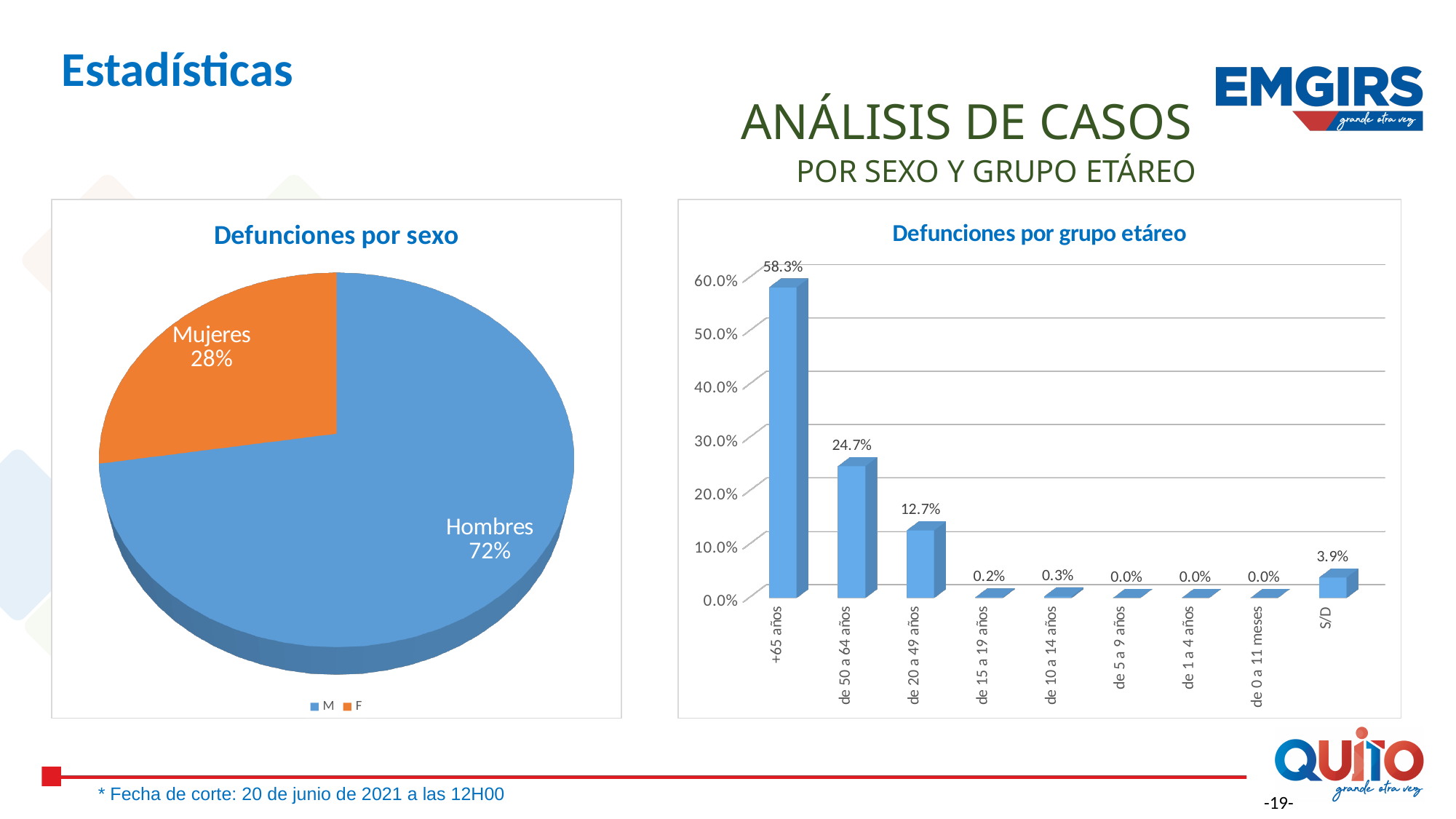
In the 'Defunciones por grupo etáreo' chart, what is the value for S/D? 3.9% In the 'Defunciones por grupo etáreo' chart, is the value for de 50 a 64 años greater or less than 20.0%? greater What kind of chart is 'Defunciones por sexo'? Pie chart What kind of chart is 'Defunciones por grupo etáreo'? Bar chart In the 'Defunciones por sexo' chart, what is the value for Mujeres? 28% In the 'Defunciones por sexo' chart, what share of the pie is Hombres? 72% In the 'Defunciones por grupo etáreo' chart, which age group has the highest value? +65 años In the 'Defunciones por grupo etáreo' chart, what is the value for de 20 a 49 años? 12.7% In the 'Defunciones por grupo etáreo' chart, how many categories are shown on the x axis? 9 In the 'Defunciones por sexo' chart, which slice is larger, Hombres or Mujeres? Hombres In the 'Defunciones por grupo etáreo' chart, what is the value for +65 años? 58.3% In the 'Defunciones por grupo etáreo' chart, what is the difference between +65 años and de 50 a 64 años? 33.6%